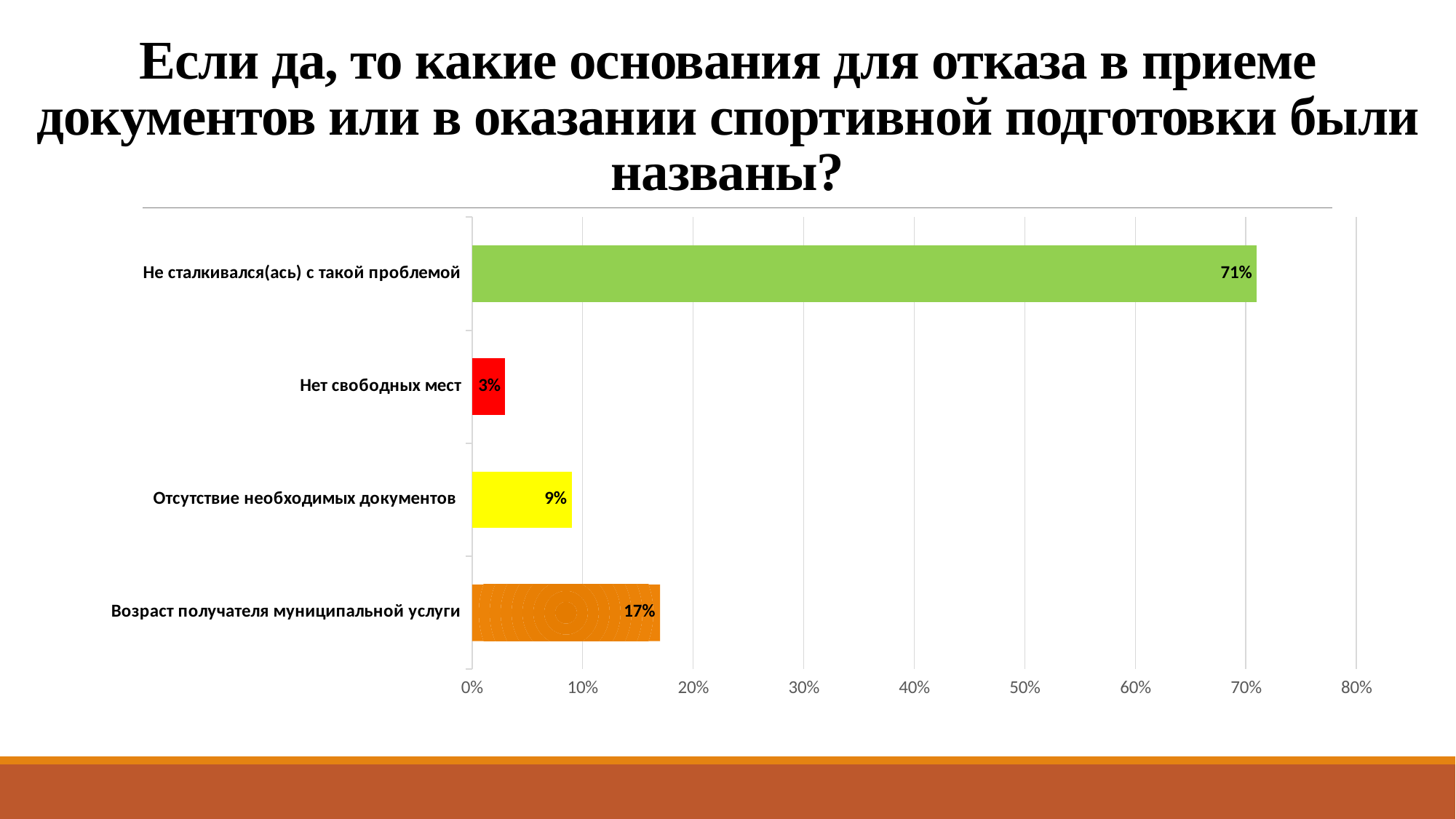
How many categories are shown in the chart? 4 What is the value for "Возраст получателя муниципальной услуги"? 17% Which category has the highest value? Не сталкивался(ась) с такой проблемой What is the value for "Нет свободных мест"? 3% What is the difference between the values for "Возраст получателя муниципальной услуги" and "Отсутствие необходимых документов"? 8% What kind of chart is shown on the slide? bar chart Is the value for "Возраст получателя муниципальной услуги" greater or less than 20%? less What is the value for "Не сталкивался(ась) с такой проблемой"? 71% What is the value for "Отсутствие необходимых документов"? 9% Which is larger: the value for "Отсутствие необходимых документов" or the value for "Нет свободных мест"? Отсутствие необходимых документов Which category has the lowest value? Нет свободных мест What colour is the bar for "Нет свободных мест"? red